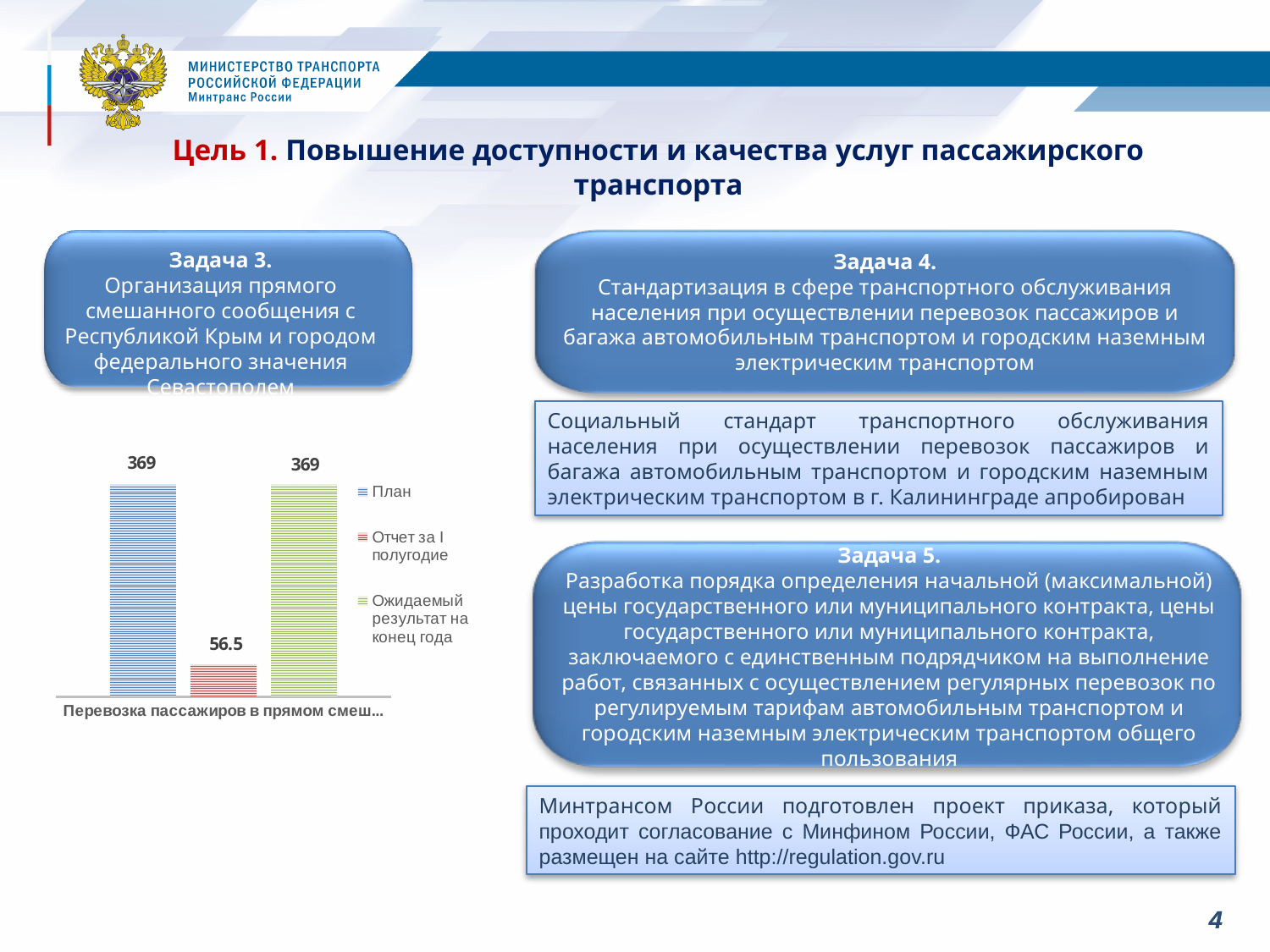
Which series has the lowest value in the chart? Отчет за I полугодие What colour is the "План" bar in the chart? blue What is the value of the "План" bar in the chart? 369 How many bars are plotted in the chart? 3 What is the value of the "Отчет за I полугодие" bar in the chart? 56.5 What colour is the "Отчет за I полугодие" bar in the chart? red What kind of chart is shown on the slide? bar chart Which is larger in the chart: the "План" value or the "Отчет за I полугодие" value? План Is the "План" value equal to the "Ожидаемый результат на конец года" value? Yes What is the value of the "Ожидаемый результат на конец года" bar in the chart? 369 How many series does the chart legend list? 3 What is the difference between the "План" value and the "Отчет за I полугодие" value? 312.5